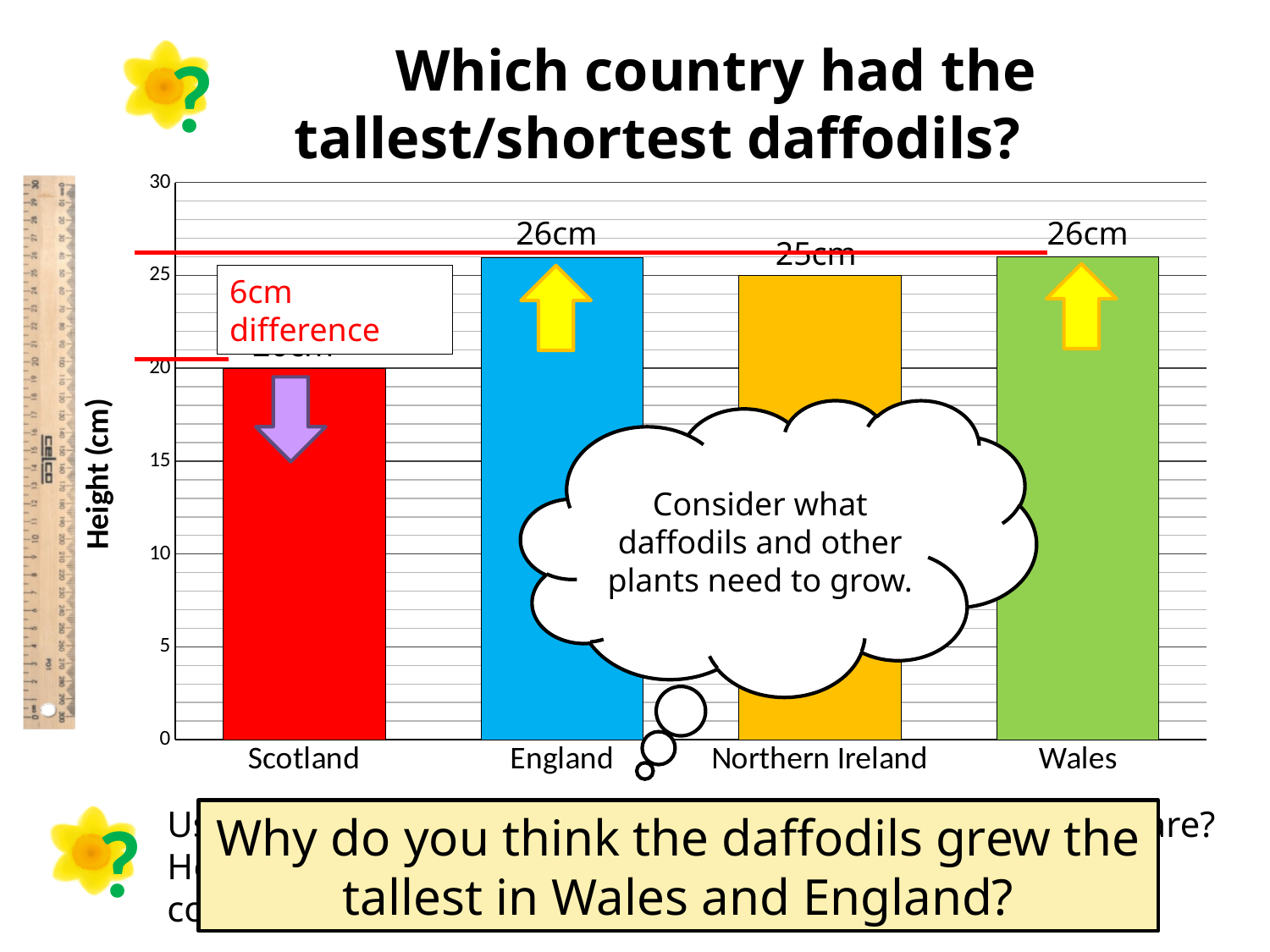
What is the daffodil height shown for Wales? 26cm What is the difference in daffodil height between Scotland and the tallest daffodils? 6cm What kind of chart is shown on the slide? Bar chart What is the label on the vertical axis of the chart? Height (cm) What is the difference in daffodil height between England and Northern Ireland? 1cm How many countries are shown on the chart? 4 Which country had the shortest daffodils? Scotland Which countries had the tallest daffodils? England and Wales What is the daffodil height shown for England? 26cm Which has taller daffodils, Northern Ireland or Scotland? Northern Ireland What is the daffodil height shown for Northern Ireland? 25cm Is the value for Scotland greater or less than 25? less